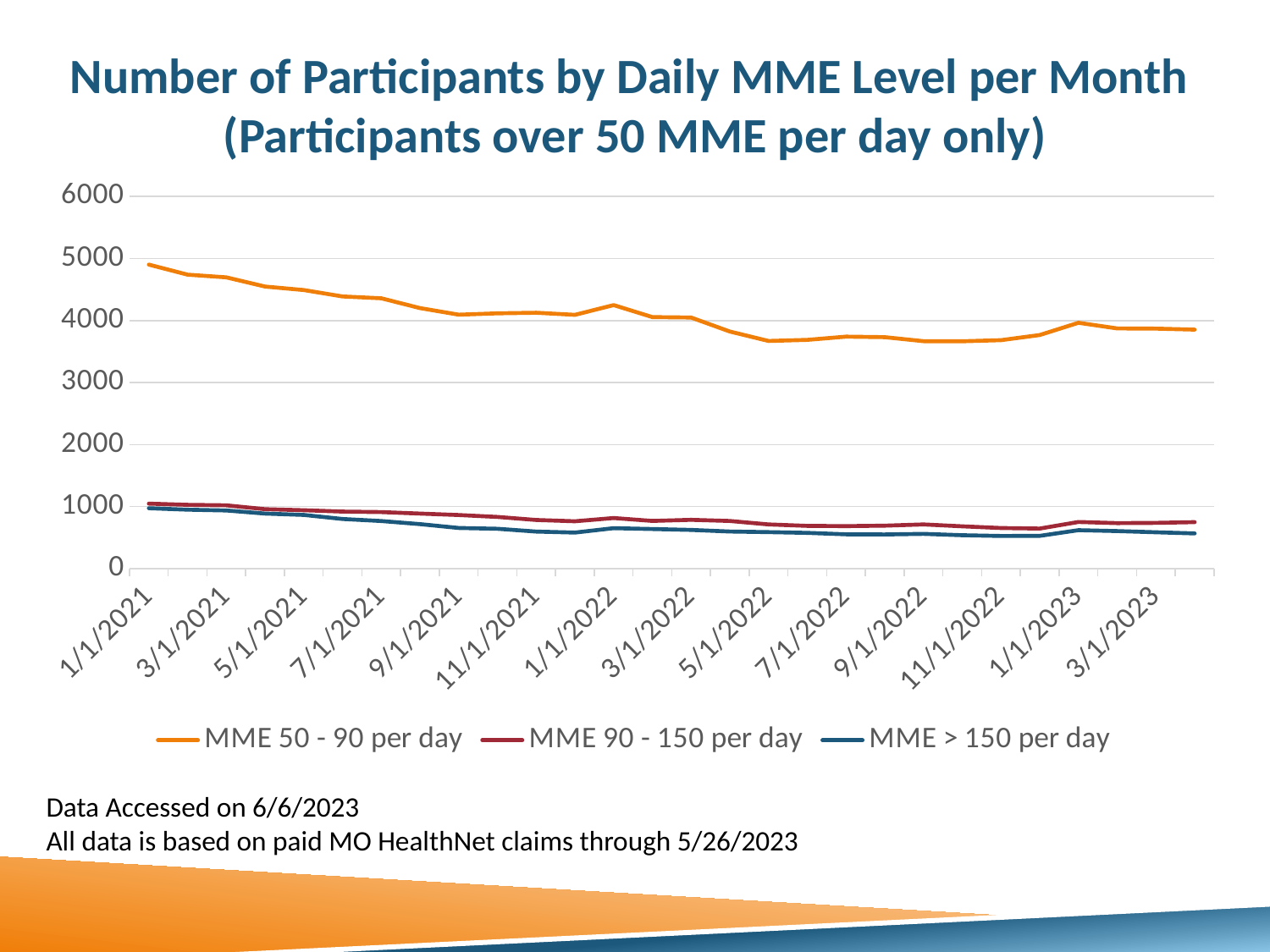
Is the value for MME 50 - 90 per day at 7/1/2022 greater or less than 4000? less How many series does the legend list? 3 Does the MME 50 - 90 per day line generally rise or fall from 1/1/2021 to 3/1/2023? Fall How many date labels are shown on the x axis? 14 Is the value for MME > 150 per day at 3/1/2023 greater or less than 1000? less Is the value for MME 50 - 90 per day at 1/1/2021 greater or less than 4000? greater At 1/1/2021, which is larger: MME 50 - 90 per day or MME > 150 per day? MME 50 - 90 per day What colour is the line for MME 50 - 90 per day? Orange Which series has the highest values throughout the chart? MME 50 - 90 per day Which series has the lowest values throughout the chart? MME > 150 per day What kind of chart is shown on the slide? Line chart